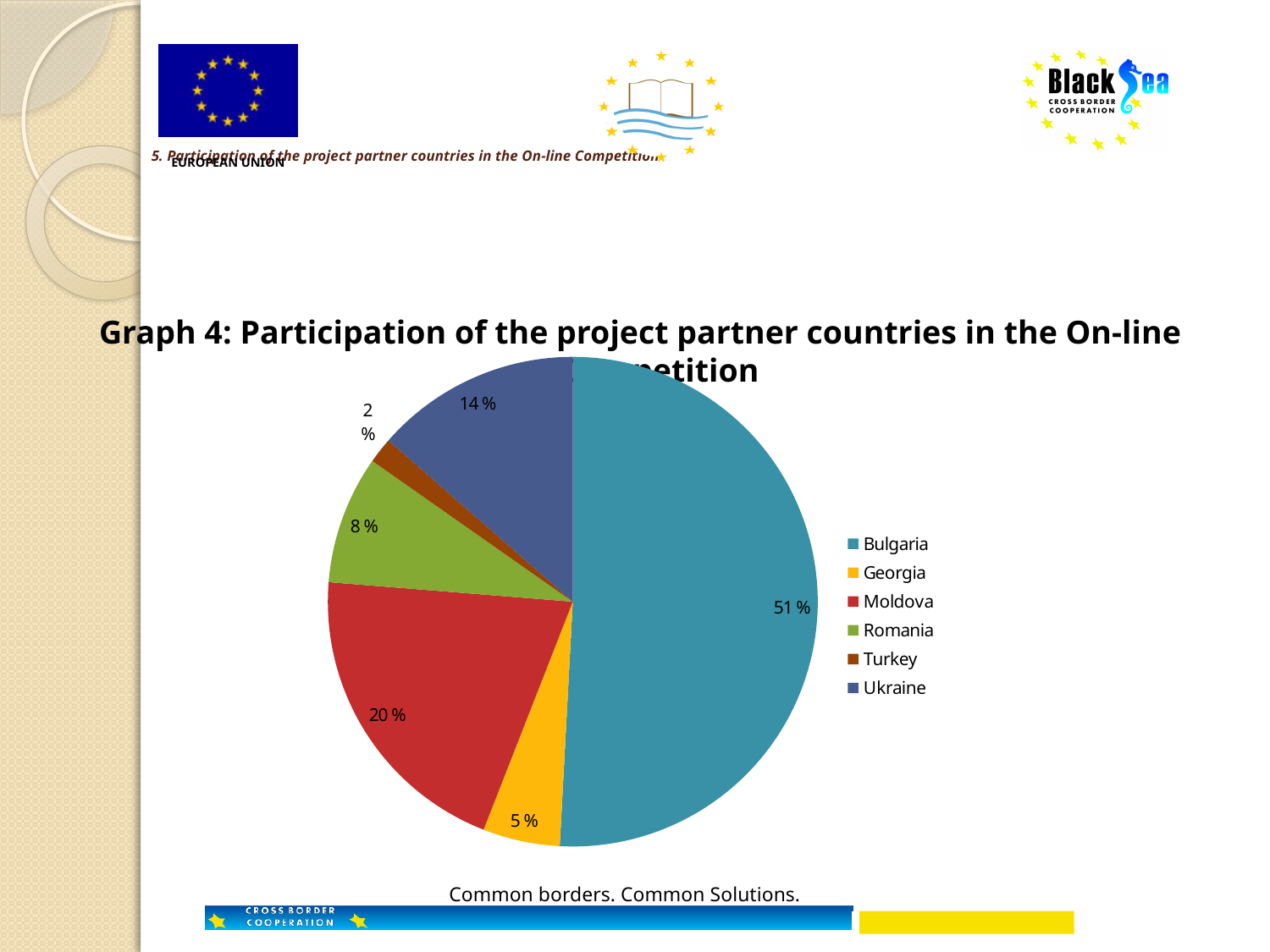
Which country has the largest slice of the pie? Bulgaria What share of the pie does Bulgaria have? 51 % Which country is represented by the red slice? Moldova What kind of chart is shown on the slide? pie chart What share of the pie does Georgia have? 5 % Which country has the smallest slice of the pie? Turkey Which has a larger share, Ukraine or Romania? Ukraine How many countries are shown in the pie chart? 6 What share of the pie does Moldova have? 20 % What share of the pie does Ukraine have? 14 % What is the difference in percentage points between Bulgaria's share and Moldova's share? 31 What share of the pie does Romania have? 8 %